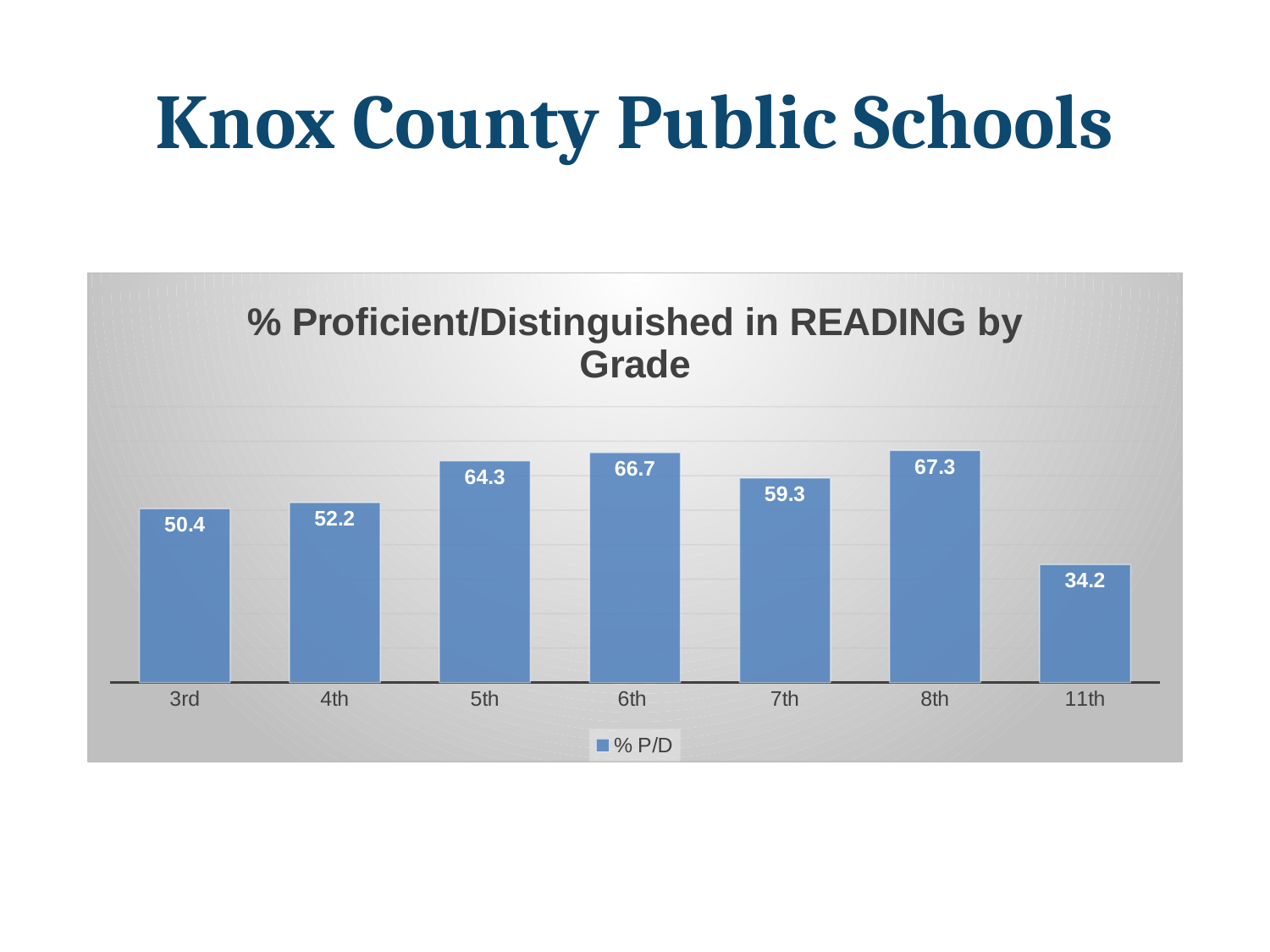
Which is larger, the value for 6th grade or the value for 7th grade? 6th What is the % P/D value for 11th grade? 34.2 Which grade has the lowest % Proficient/Distinguished in reading? 11th What is the % P/D value for 3rd grade? 50.4 Which grade has the highest % Proficient/Distinguished in reading? 8th What is the % P/D value for 6th grade? 66.7 What is the difference between the 5th grade and 4th grade values? 12.1 How many grades are shown on the chart? 7 What is the title of the chart? % Proficient/Distinguished in READING by Grade What kind of chart is shown on the slide? Bar chart How many series does the legend list? 1 What is the difference between the 8th grade and 11th grade values? 33.1